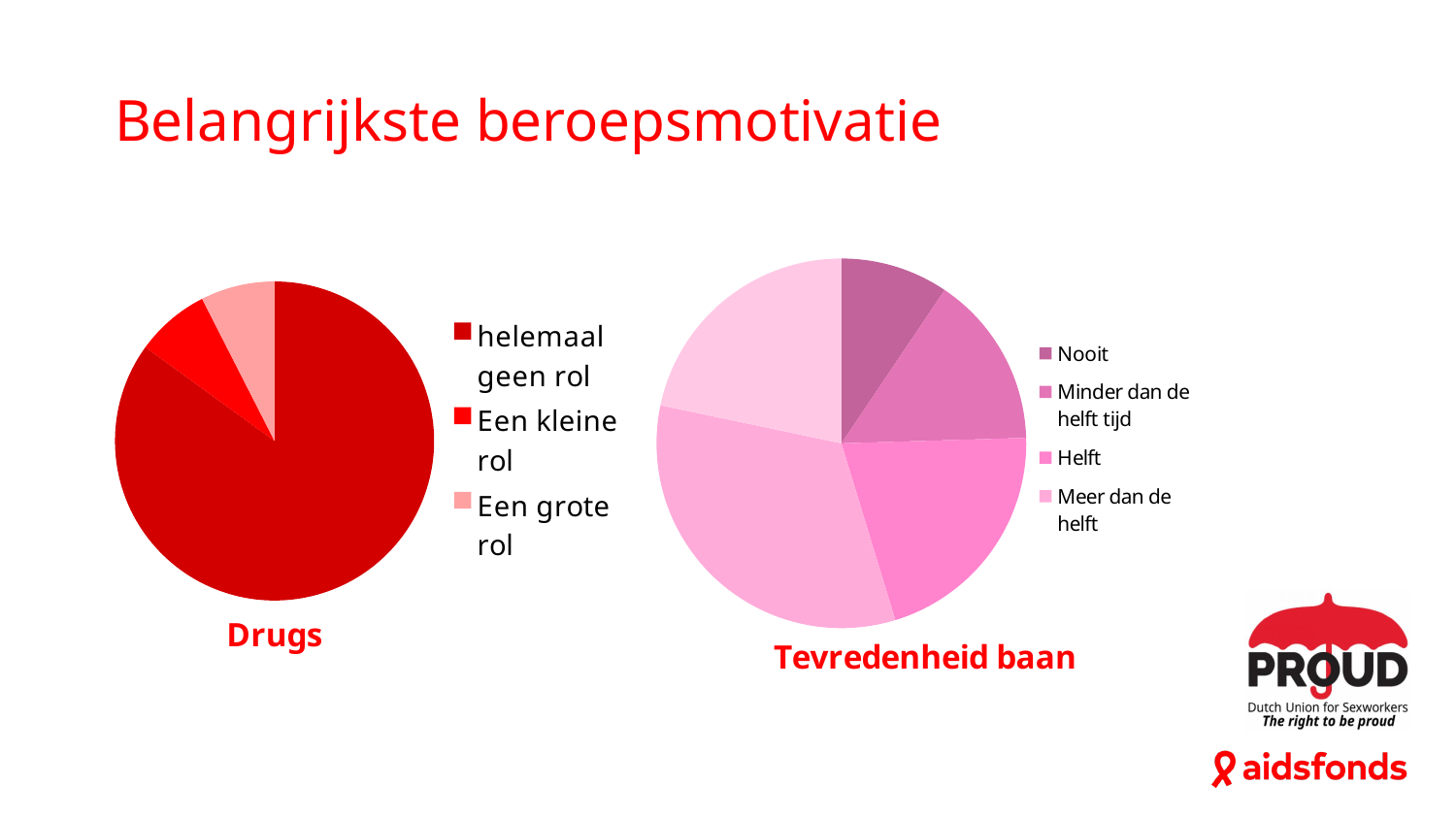
In the "Drugs" chart, how many categories does the legend list? 3 In the "Tevredenheid baan" chart, which category has the smallest slice? Nooit In the "Tevredenheid baan" chart, which category has the largest slice? Meer dan de helft In the "Tevredenheid baan" chart, which slice is larger: "Meer dan de helft" or "Helft"? Meer dan de helft In the "Drugs" chart, which category has the largest slice? helemaal geen rol In the "Drugs" chart, which slice is larger: "helemaal geen rol" or "Een grote rol"? helemaal geen rol What kind of chart is the chart titled "Tevredenheid baan"? pie chart In the "Tevredenheid baan" chart, which slice is larger: "Helft" or "Nooit"? Helft How many pie charts are shown on the slide? 2 What is the title of the slide containing the two pie charts? Belangrijkste beroepsmotivatie What kind of chart is the chart titled "Drugs"? pie chart In the "Tevredenheid baan" chart, how many categories does the legend list? 4